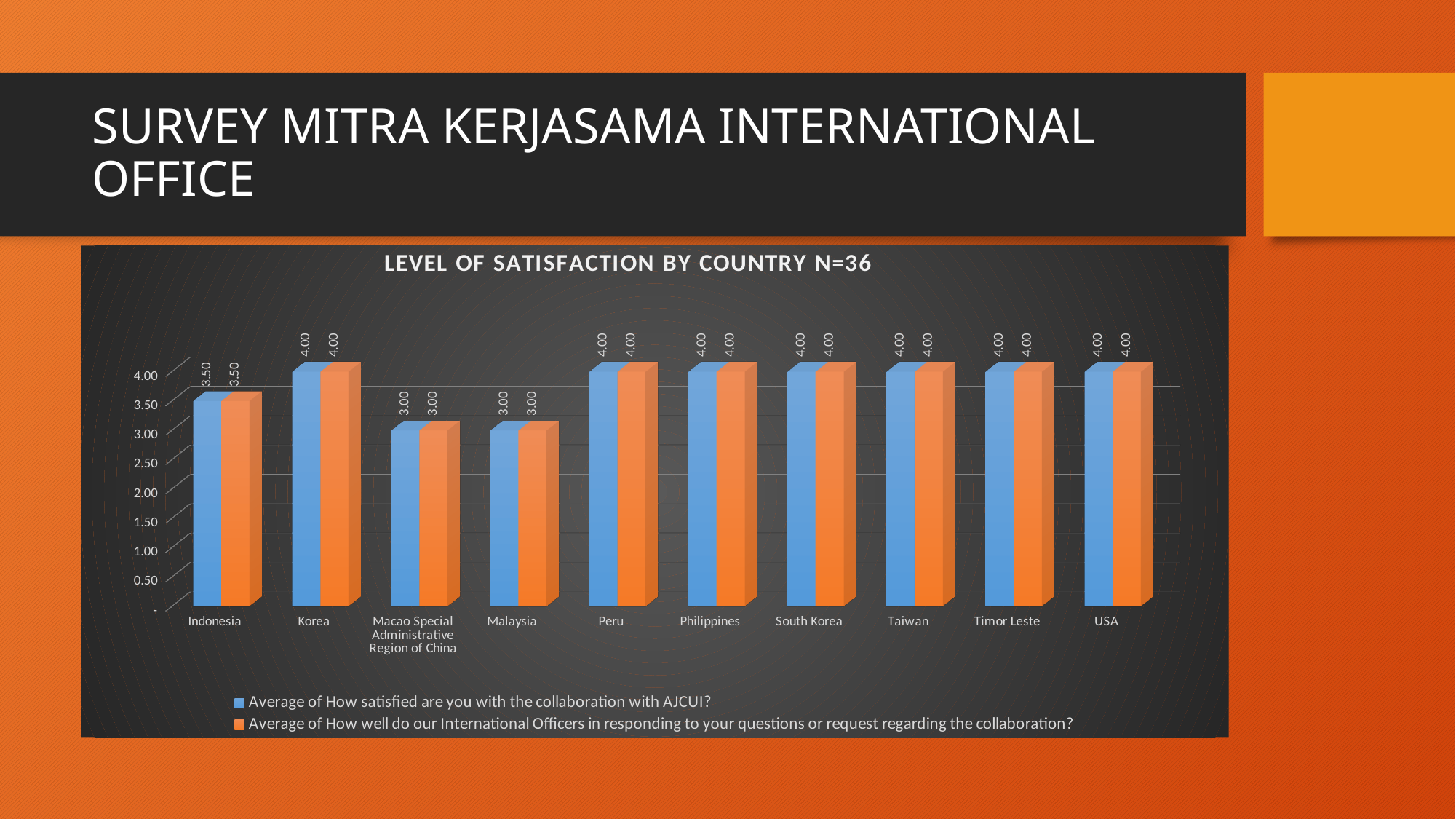
What kind of chart is shown on the slide? Bar chart What is the value for Malaysia in the 'Average of How well do our International Officers in responding to your questions or request regarding the collaboration?' series? 3.00 What is the value for Indonesia in the 'Average of How satisfied are you with the collaboration with AJCUI?' series? 3.50 What is the difference between Korea and Indonesia in the 'Average of How satisfied are you with the collaboration with AJCUI?' series? 0.50 How many countries are shown on the x axis of the chart? 10 Is the value for Indonesia in the 'Average of How satisfied are you with the collaboration with AJCUI?' series greater or less than 3.00? greater What is the difference between Indonesia and Malaysia in the 'Average of How well do our International Officers in responding to your questions or request regarding the collaboration?' series? 0.50 What is the value for Peru in the 'Average of How satisfied are you with the collaboration with AJCUI?' series? 4.00 What is the value for Macao Special Administrative Region of China in the 'Average of How satisfied are you with the collaboration with AJCUI?' series? 3.00 How many series does the legend list? 2 Which is larger in the 'Average of How satisfied are you with the collaboration with AJCUI?' series: USA or Malaysia? USA Which two countries have the lowest values in the 'Average of How satisfied are you with the collaboration with AJCUI?' series? Macao Special Administrative Region of China and Malaysia